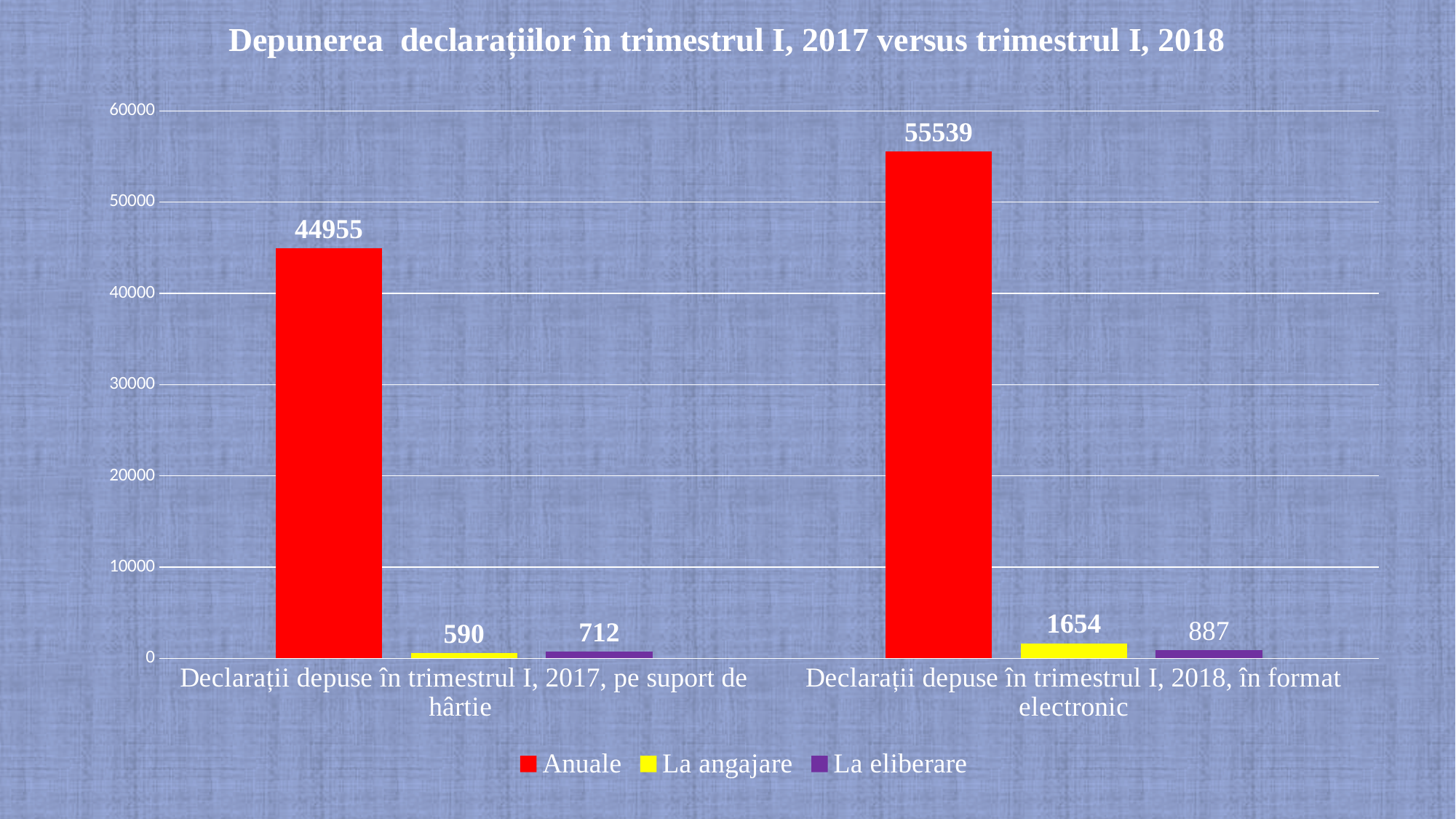
What is the difference between the Anuale values for 2018 and 2017? 10584 What is the value of La angajare for 'Declarații depuse în trimestrul I, 2018, în format electronic'? 1654 What is the value of La angajare for 'Declarații depuse în trimestrul I, 2017, pe suport de hârtie'? 590 What is the value of La eliberare for 'Declarații depuse în trimestrul I, 2018, în format electronic'? 887 What is the value of Anuale for 'Declarații depuse în trimestrul I, 2017, pe suport de hârtie'? 44955 How many categories are shown on the x axis? 2 How many series does the legend list? 3 What is the value of Anuale for 'Declarații depuse în trimestrul I, 2018, în format electronic'? 55539 What kind of chart is shown on the slide? Bar chart Is the Anuale value for 'Declarații depuse în trimestrul I, 2017, pe suport de hârtie' greater or less than 40000? greater What colour represents the La angajare series? Yellow Which category has the higher Anuale value? Declarații depuse în trimestrul I, 2018, în format electronic